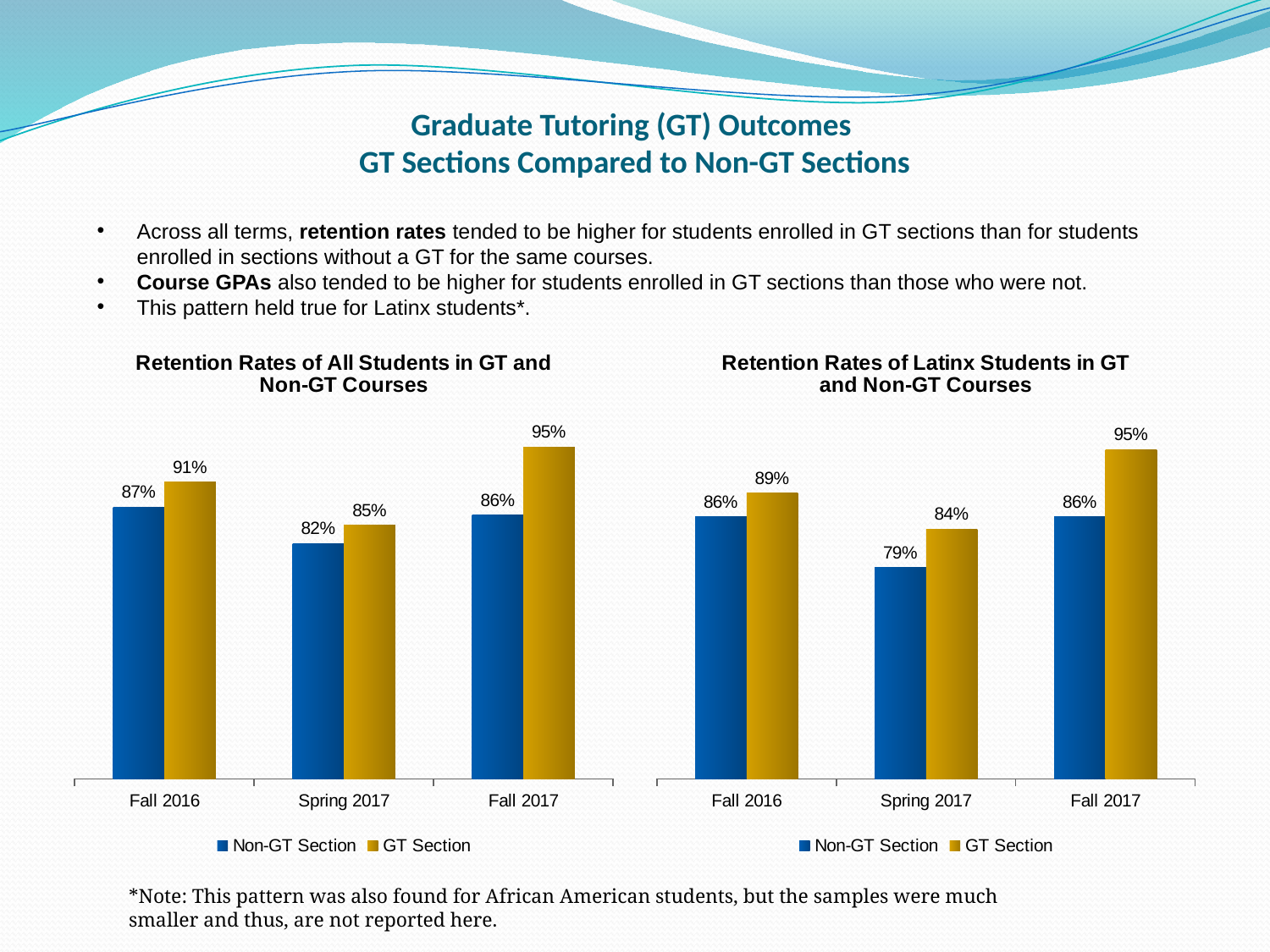
In the 'Retention Rates of All Students in GT and Non-GT Courses' chart, which is larger in Fall 2016: the GT Section or the Non-GT Section retention rate? GT Section How many terms are shown on the x axis of the 'Retention Rates of Latinx Students in GT and Non-GT Courses' chart? 3 In the 'Retention Rates of Latinx Students in GT and Non-GT Courses' chart, what is the retention rate for the GT Section in Fall 2016? 89% In the 'Retention Rates of All Students in GT and Non-GT Courses' chart, what is the difference between the GT Section and Non-GT Section retention rates in Fall 2017? 9% In the 'Retention Rates of All Students in GT and Non-GT Courses' chart, what is the retention rate for the Non-GT Section in Spring 2017? 82% In the 'Retention Rates of All Students in GT and Non-GT Courses' chart, what is the retention rate for the GT Section in Fall 2017? 95% In the 'Retention Rates of Latinx Students in GT and Non-GT Courses' chart, what is the difference between the GT Section and Non-GT Section retention rates in Spring 2017? 5% How many series does the legend list in the 'Retention Rates of All Students in GT and Non-GT Courses' chart? 2 In the 'Retention Rates of All Students in GT and Non-GT Courses' chart, which term has the lowest Non-GT Section retention rate? Spring 2017 In the 'Retention Rates of Latinx Students in GT and Non-GT Courses' chart, which term has the highest GT Section retention rate? Fall 2017 In the 'Retention Rates of Latinx Students in GT and Non-GT Courses' chart, what is the retention rate for the Non-GT Section in Spring 2017? 79% What kind of chart is the 'Retention Rates of Latinx Students in GT and Non-GT Courses' chart? Bar chart